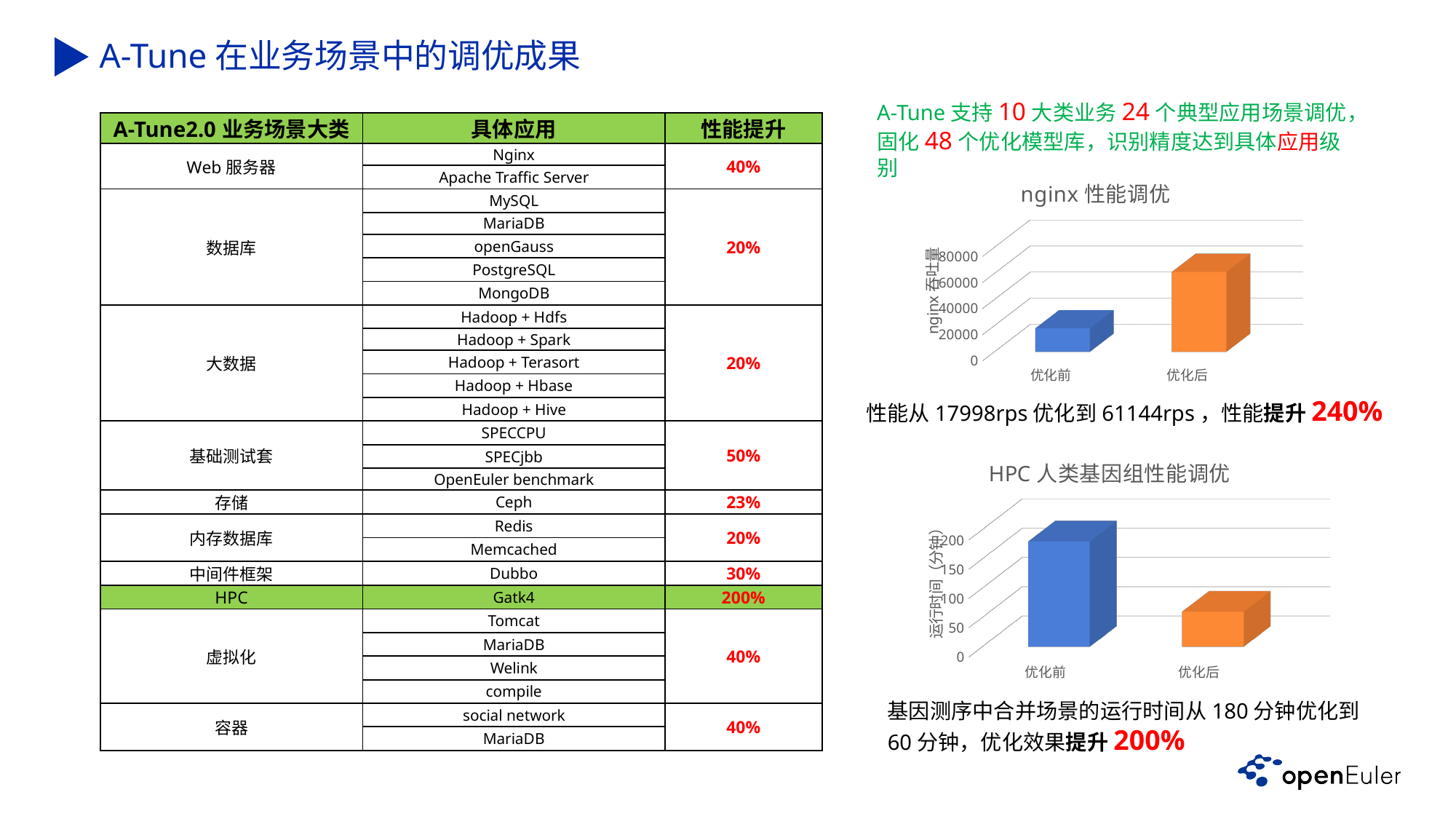
In the "nginx 性能调优" chart, do the values rise or fall from 优化前 to 优化后? rise What kind of chart is the "HPC 人类基因组性能调优" chart? bar chart In the "nginx 性能调优" chart, which category has the higher value? 优化后 In the "HPC 人类基因组性能调优" chart, is the value for 优化后 greater or less than 100? less In the "HPC 人类基因组性能调优" chart, is the value for 优化前 greater or less than 150? greater What is the y-axis title of the "HPC 人类基因组性能调优" chart? 运行时间（分钟） How many categories are shown on the x axis of the "nginx 性能调优" chart? 2 In the "HPC 人类基因组性能调优" chart, which category has the lower value? 优化后 In the "nginx 性能调优" chart, is the value for 优化前 greater or less than 20000? less In the "HPC 人类基因组性能调优" chart, do the values rise or fall from 优化前 to 优化后? fall What kind of chart is the "nginx 性能调优" chart? bar chart